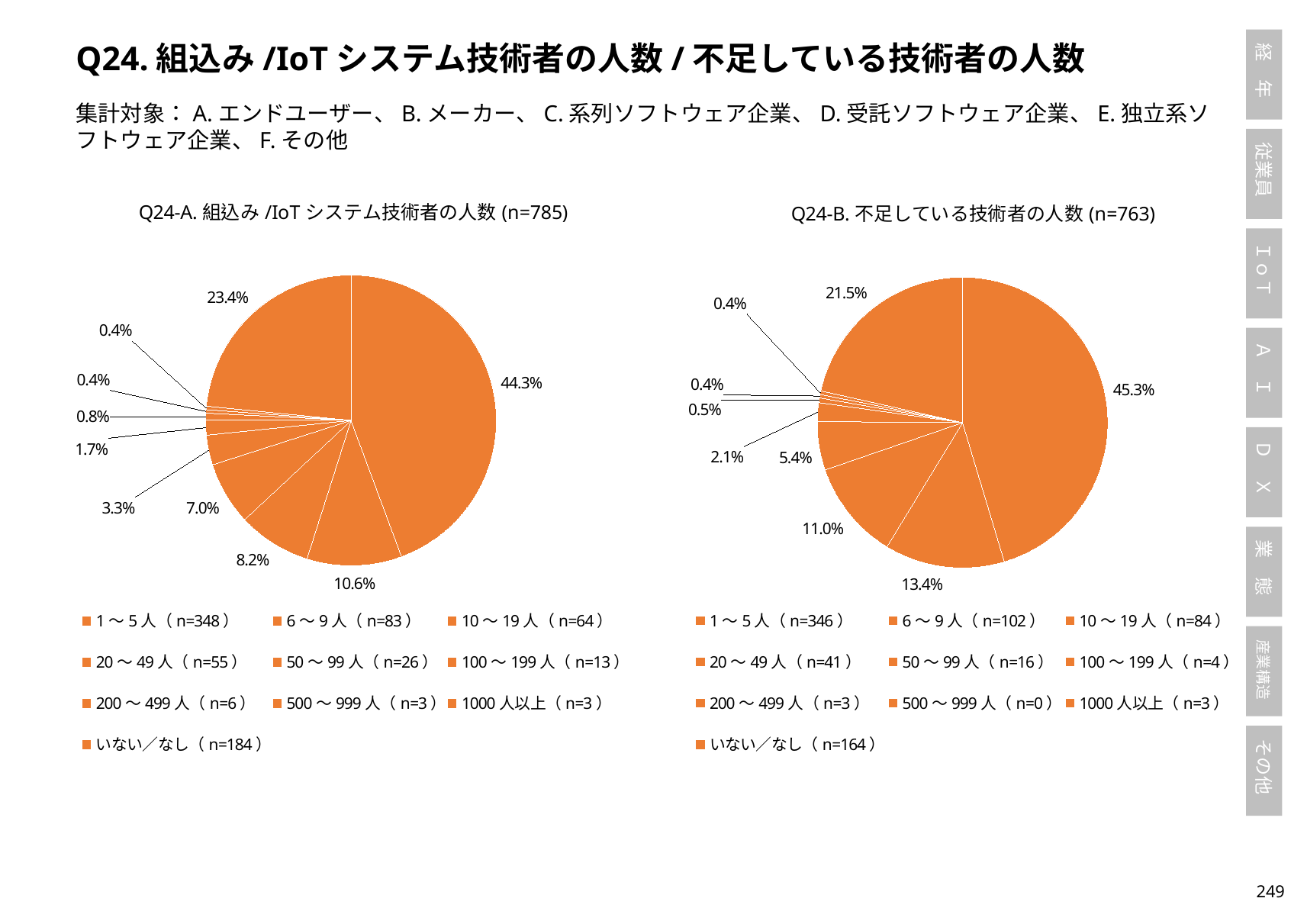
How many categories does the legend of the Q24-A chart (left) list? 10 In the Q24-A chart (left), what percentage is shown for the いない／なし category (n=184)? 23.4% Which is larger: the largest slice in the Q24-A chart (left) or the largest slice in the Q24-B chart (right)? Q24-B (45.3%) In the Q24-A chart (left), what percentage is shown for the 6～9人 category (n=83)? 10.6% What is the difference between the largest slice in the Q24-B chart (45.3%) and the largest slice in the Q24-A chart (44.3%)? 1.0% In the Q24-B chart (right), what percentage is shown for the 6～9人 category (n=102)? 13.4% In the Q24-B chart (right), what percentage is shown for the largest slice? 45.3% In the Q24-B chart (right), what is the n value shown in the legend for the 500～999人 category? 0 In the Q24-A chart (left), what percentage is shown for the largest slice? 44.3% What is the sample size (n) stated in the title of the Q24-B chart (right)? 763 In the Q24-B chart (right), what percentage is shown for the いない／なし category (n=164)? 21.5% What type of chart is used for Q24-A and Q24-B? Pie chart